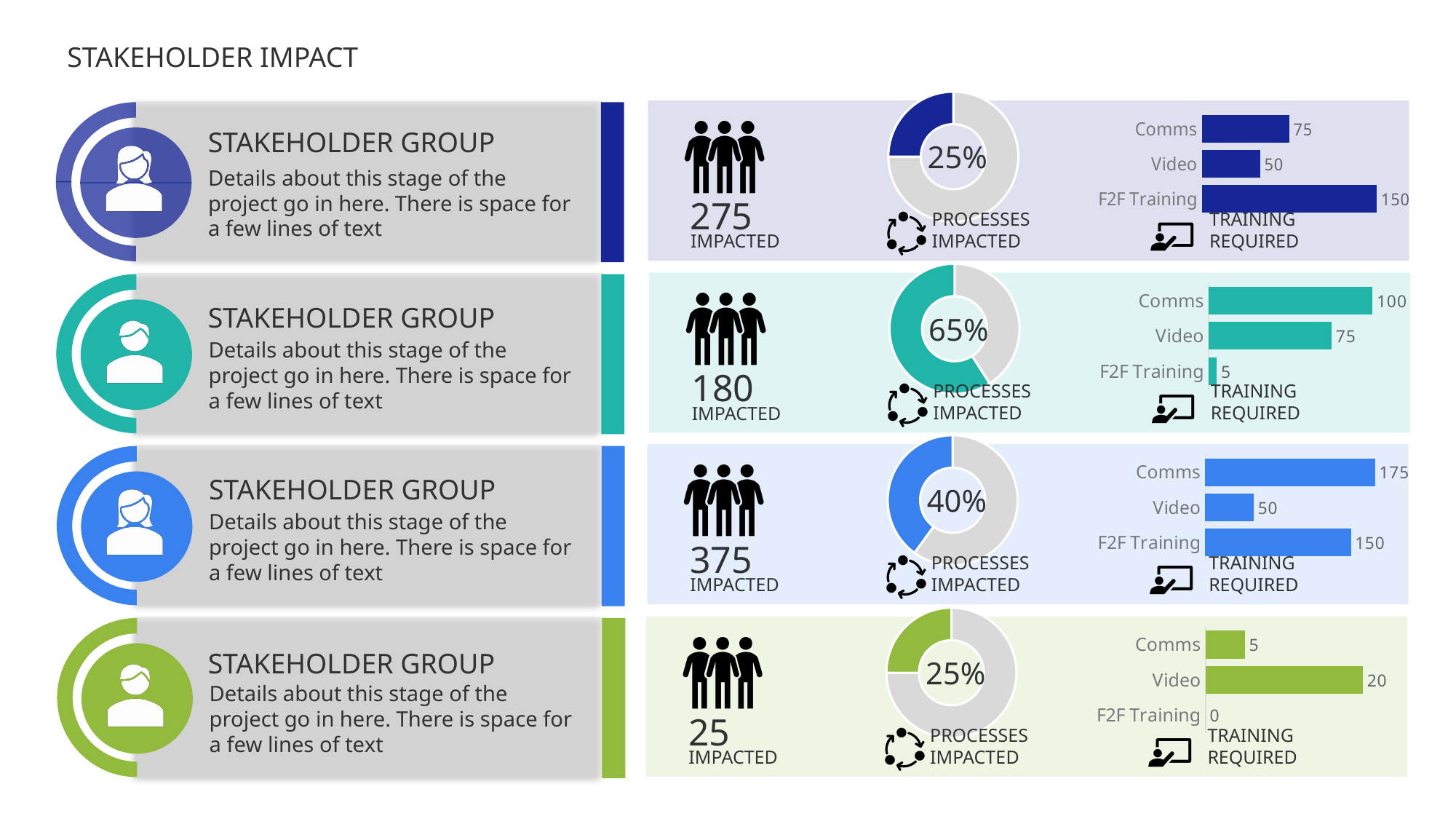
In the top row's Training Required bar chart, what is the value for F2F Training? 150 In the third row's Training Required bar chart, what is the difference between Comms and F2F Training? 25 In the top row's Training Required bar chart, what is the difference between F2F Training and Video? 100 In the second row's Training Required bar chart, which is larger, Video or F2F Training? Video What percentage does the Processes Impacted donut chart in the third row show? 40% In the third row's Training Required bar chart, which category has the highest value? Comms In the second row's Training Required bar chart, what is the value for Comms? 100 What kind of chart is used for Training Required in each row? Bar chart How many categories does each Training Required bar chart show? 3 What percentage does the Processes Impacted donut chart in the second row show? 65% In the bottom row's Training Required bar chart, which category has the lowest value? F2F Training What colour are the bars in the bottom row's Training Required bar chart? Green